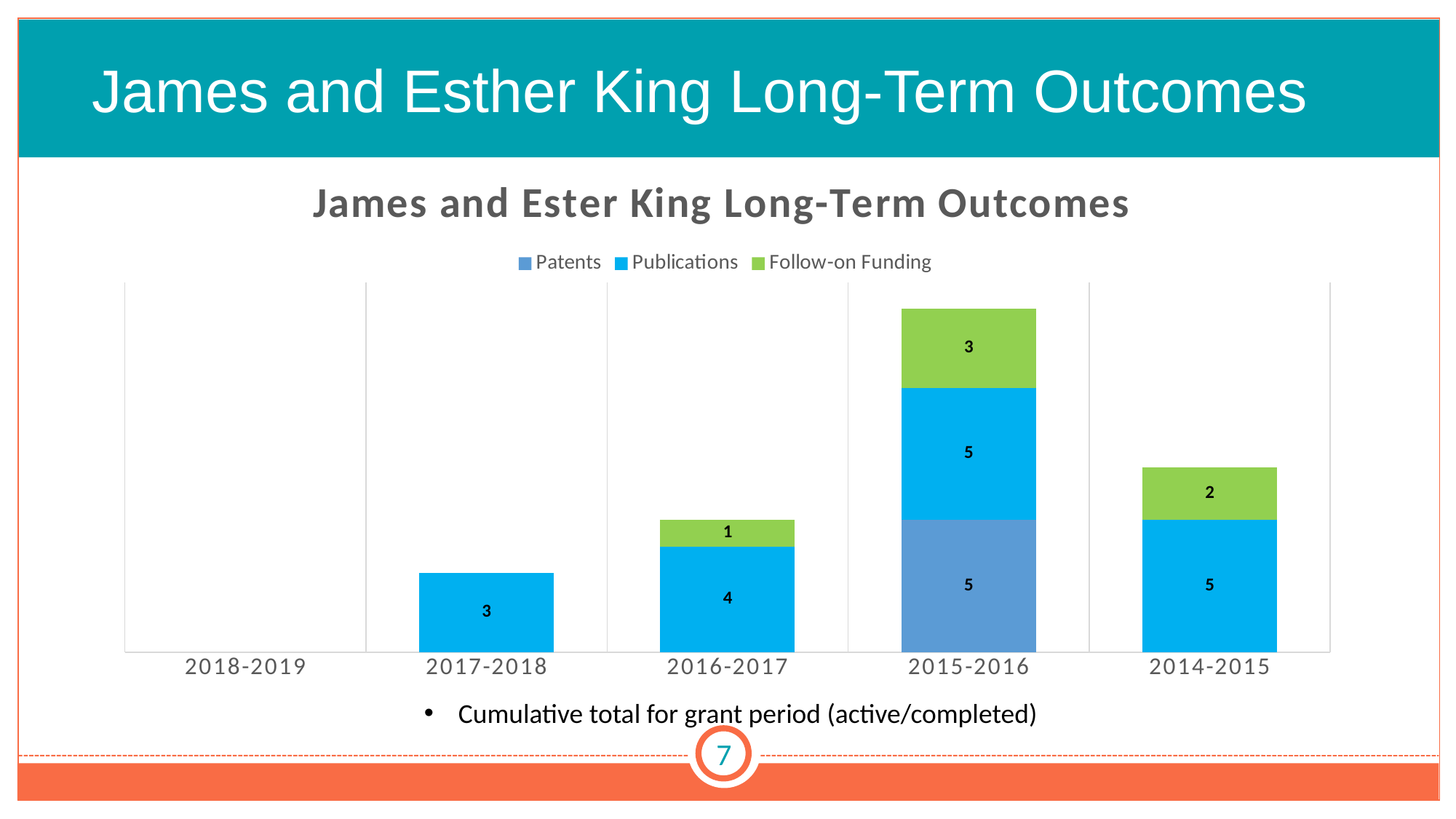
What is the value for Follow-on Funding in 2016-2017? 1 What is the value for Follow-on Funding in 2014-2015? 2 How many series does the legend list? 3 What is the value for Patents in 2015-2016? 5 What is the total of the stacked bar for 2014-2015? 7 Which series is shown in green in the legend? Follow-on Funding Which grant period has the tallest stacked bar? 2015-2016 What is the total of the stacked bar for 2015-2016? 13 How many grant periods are shown on the x axis? 5 What is the value for Publications in 2017-2018? 3 What kind of chart is shown on the slide? Stacked bar chart What is the difference between Publications in 2015-2016 and Publications in 2017-2018? 2